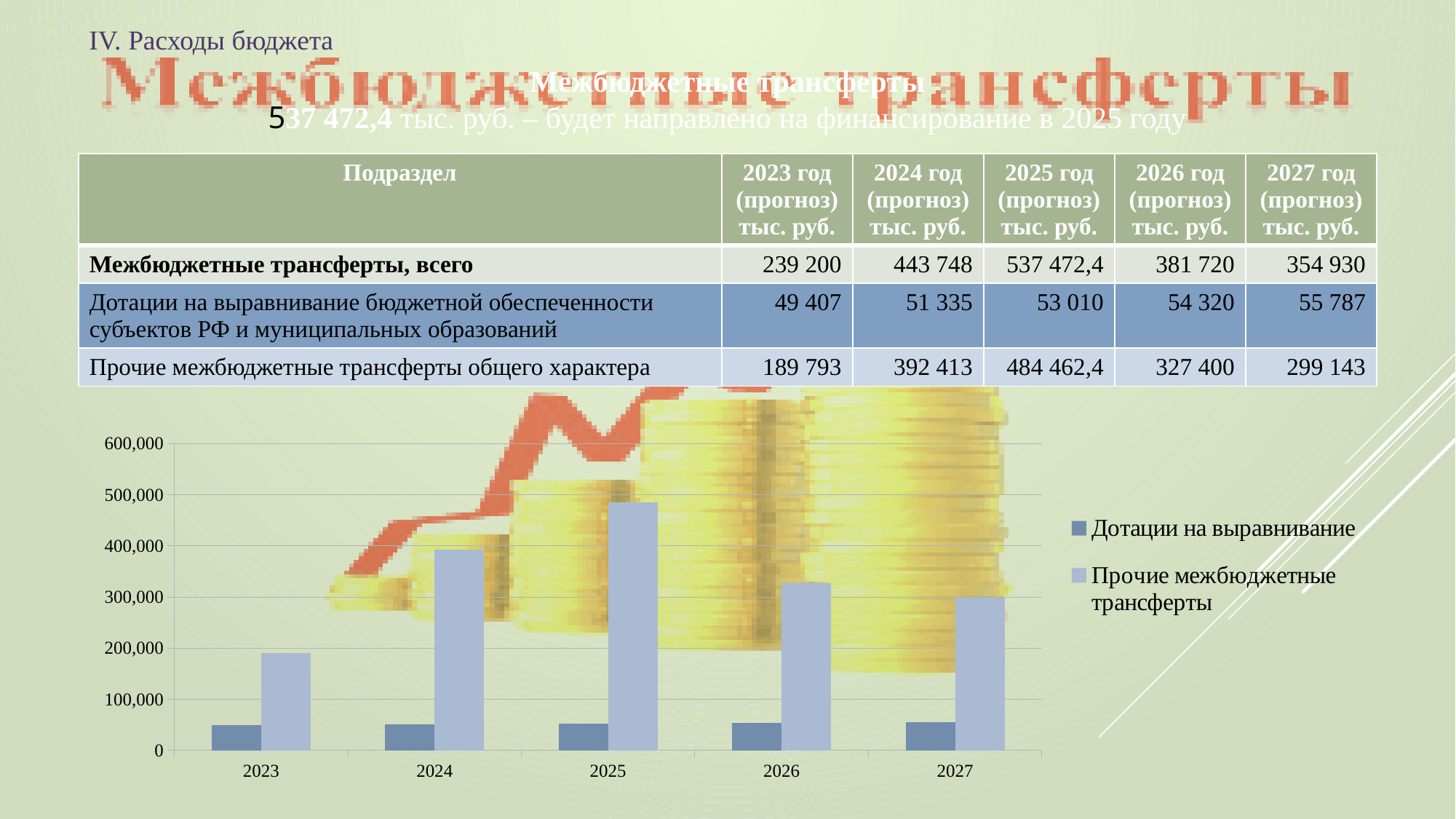
What kind of chart is shown on the slide? bar chart Is the value for Прочие межбюджетные трансферты in 2024 greater or less than 300,000? greater In which year is the bar for Прочие межбюджетные трансферты the highest? 2025 In which year is the bar for Прочие межбюджетные трансферты the lowest? 2023 How many years are shown on the x axis of the chart? 5 Is the value for Прочие межбюджетные трансферты in 2027 greater or less than 400,000? less Is the value for Дотации на выравнивание in 2023 greater or less than 100,000? less How many series does the chart legend list? 2 According to the table on the slide, what is the value of Прочие межбюджетные трансферты общего характера for 2025? 484 462,4 What are the two legend entries of the chart? Дотации на выравнивание; Прочие межбюджетные трансферты Which is larger: Прочие межбюджетные трансферты in 2024 or in 2026? 2024 Do the bars for Дотации на выравнивание rise or fall from 2023 to 2027? rise